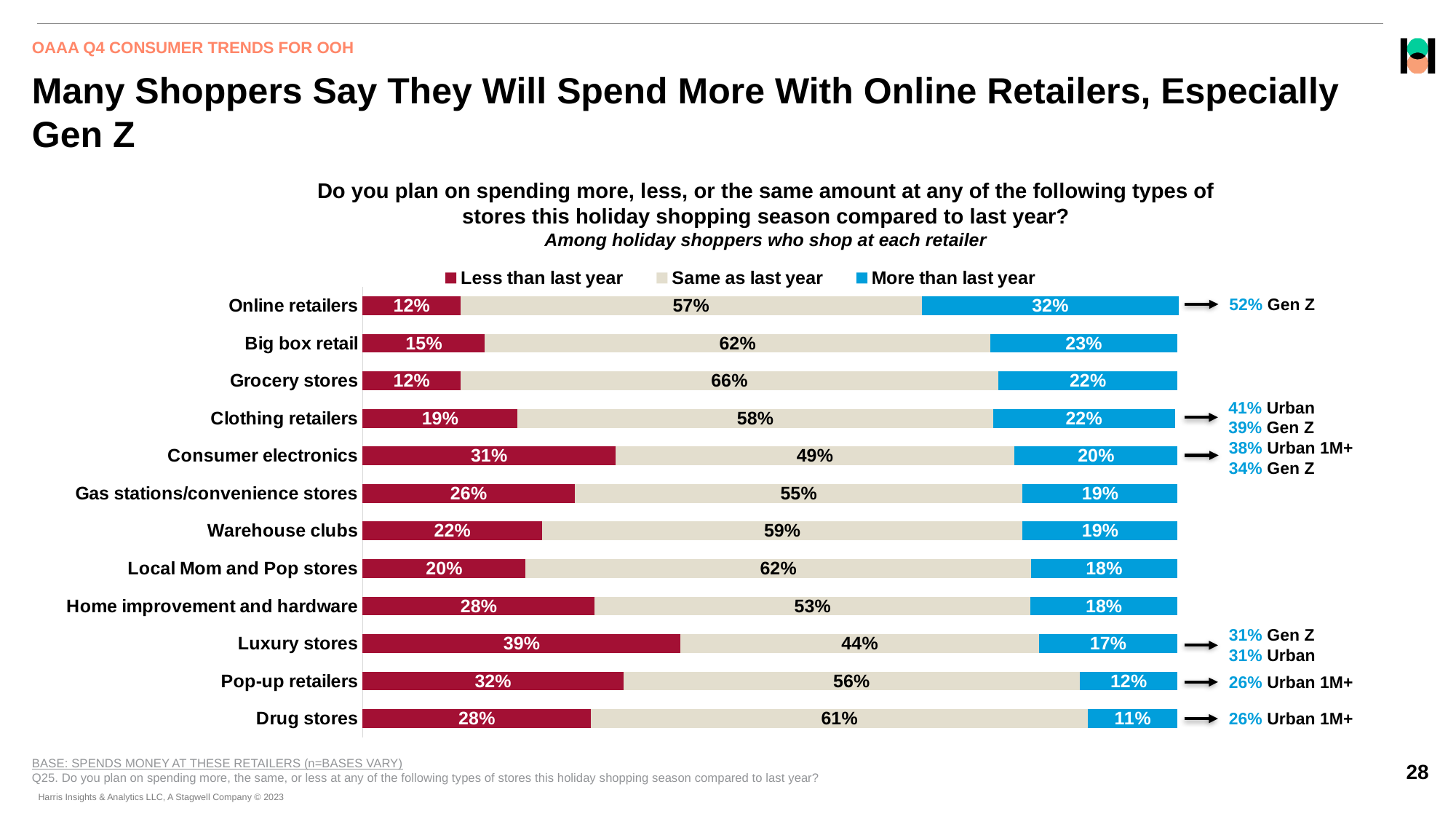
What kind of chart is shown on the slide? Stacked bar chart How many store types are shown in the chart? 12 How many series does the legend list? 3 What percentage of shoppers plan to spend less than last year at luxury stores? 39% What percentage of holiday shoppers plan to spend more than last year at online retailers? 32% Which store type has the lowest share of shoppers planning to spend more than last year? Drug stores Which is larger: the 'Less than last year' share for consumer electronics or for pop-up retailers? Pop-up retailers According to the annotation next to the online retailers bar, what percentage of Gen Z plan to spend more at online retailers? 52% Which store type has the highest share of shoppers planning to spend less than last year? Luxury stores What is the difference between the 'More than last year' percentages for online retailers and big box retail? 9% What percentage of shoppers plan to spend the same as last year at grocery stores? 66% Which store type has the highest share of shoppers planning to spend more than last year? Online retailers